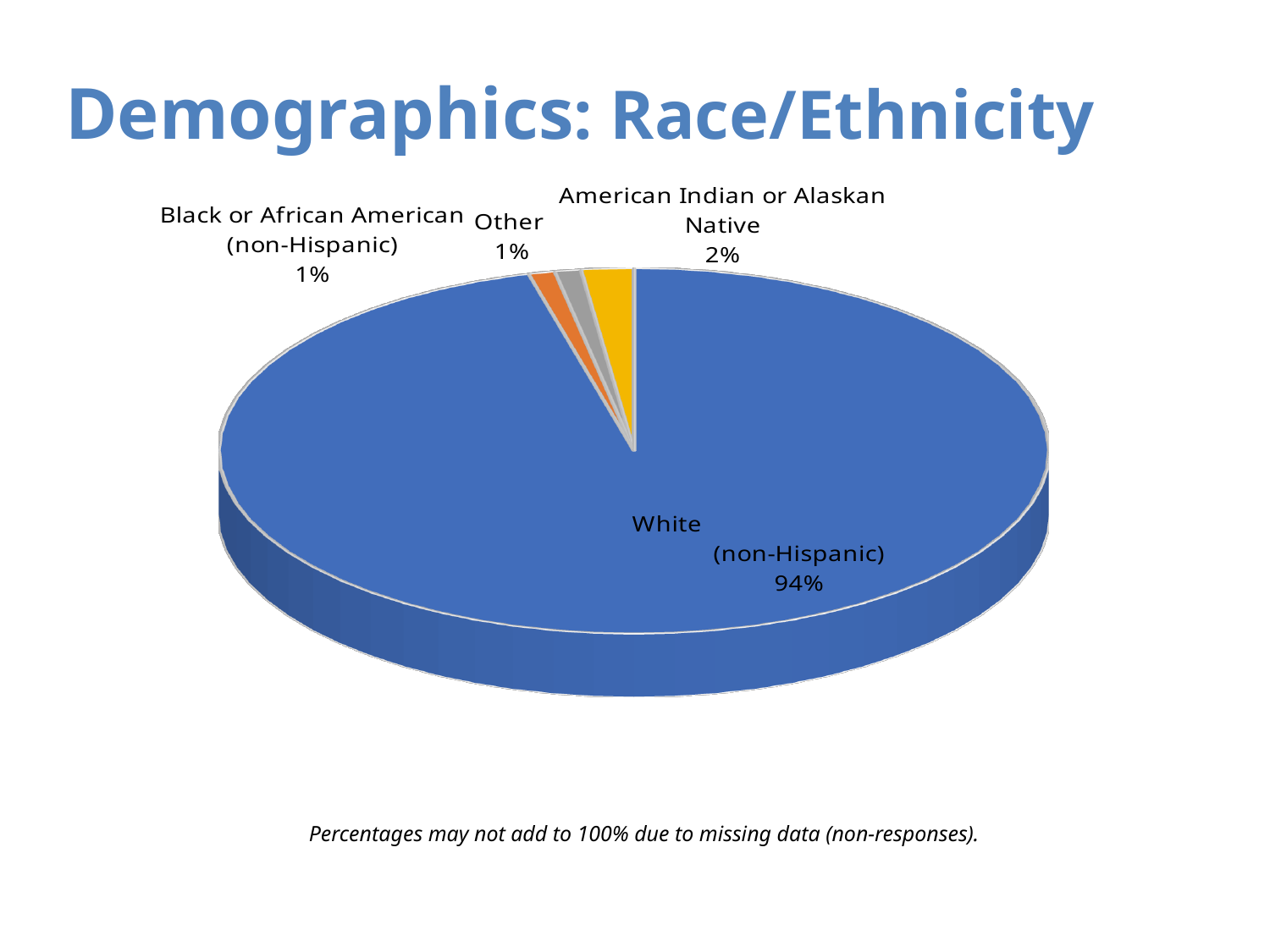
What percentage of the pie is Black or African American (non-Hispanic)? 1% What kind of chart is shown on the slide? Pie chart What percentage of the pie is White (non-Hispanic)? 94% What colour is the White (non-Hispanic) slice? Blue What is the difference in percentage points between White (non-Hispanic) and American Indian or Alaskan Native? 92 What percentage of the pie is Other? 1% How many categories are shown in the pie chart? 4 Which category has the largest share of the pie? White (non-Hispanic) Which is larger, the share for American Indian or Alaskan Native or the share for Other? American Indian or Alaskan Native What is the title of the slide? Demographics: Race/Ethnicity What percentage of the pie is American Indian or Alaskan Native? 2%